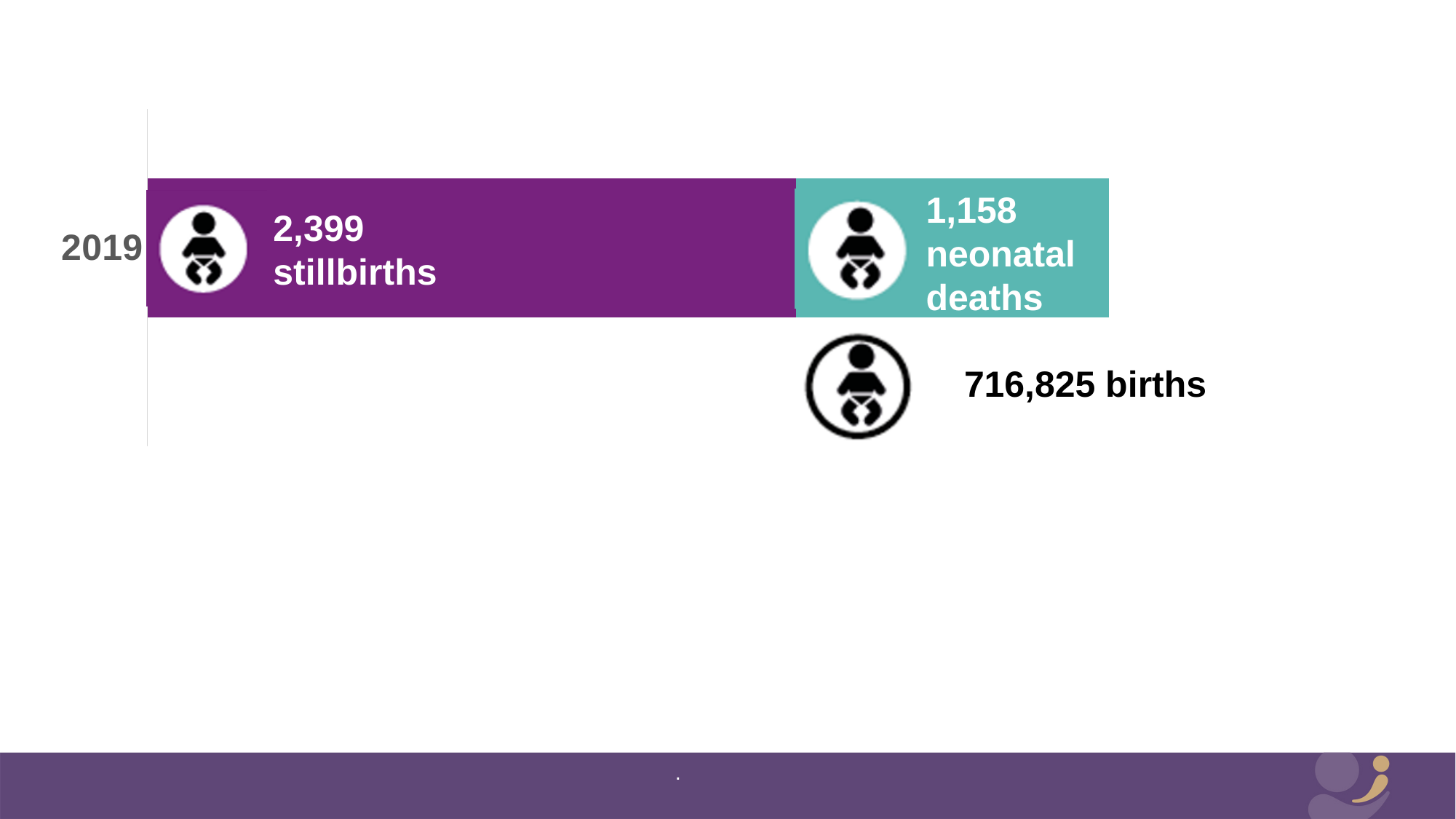
How many stillbirths are shown for 2019? 2,399 What is the difference between the number of stillbirths and the number of neonatal deaths? 1,241 What kind of chart is shown on the slide? bar chart Which year does the bar represent? 2019 How many segments make up the stacked bar? 2 What is the combined total of stillbirths and neonatal deaths in the stacked bar? 3,557 How many births are shown on the slide? 716,825 births What colour is the neonatal deaths segment of the bar? teal Which is larger, the number of stillbirths or the number of neonatal deaths? stillbirths How many neonatal deaths are shown for 2019? 1,158 What colour is the stillbirths segment of the bar? purple